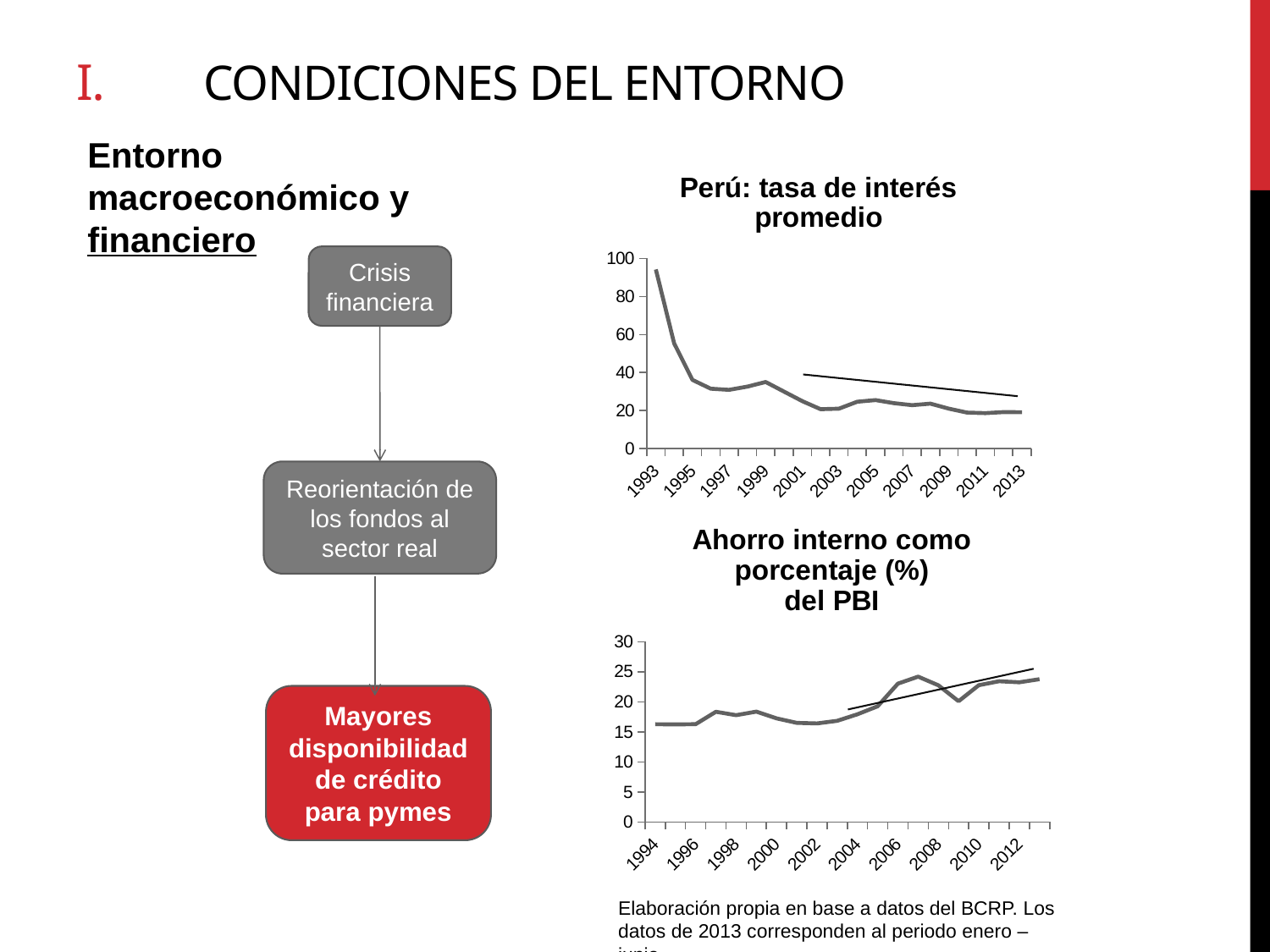
In the 'Ahorro interno como porcentaje (%) del PBI' chart, is the value for 2007 greater or less than 20? greater What is the title of the upper chart on the slide? Perú: tasa de interés promedio In the 'Perú: tasa de interés promedio' chart, do values generally rise or fall from 1993 to 2013? fall In the 'Perú: tasa de interés promedio' chart, which year has the highest value? 1993 In the 'Ahorro interno como porcentaje (%) del PBI' chart, which is larger, the value for 2007 or the value for 1994? 2007 What kind of chart is the 'Ahorro interno como porcentaje (%) del PBI' chart? line chart In the 'Ahorro interno como porcentaje (%) del PBI' chart, is the value for 1994 greater or less than 20? less What kind of chart is the 'Perú: tasa de interés promedio' chart? line chart In the 'Ahorro interno como porcentaje (%) del PBI' chart, do values generally rise or fall from 1994 to 2012? rise In the 'Perú: tasa de interés promedio' chart, which is larger, the value for 1993 or the value for 2013? 1993 In the 'Perú: tasa de interés promedio' chart, is the value for 1993 greater or less than 80? greater